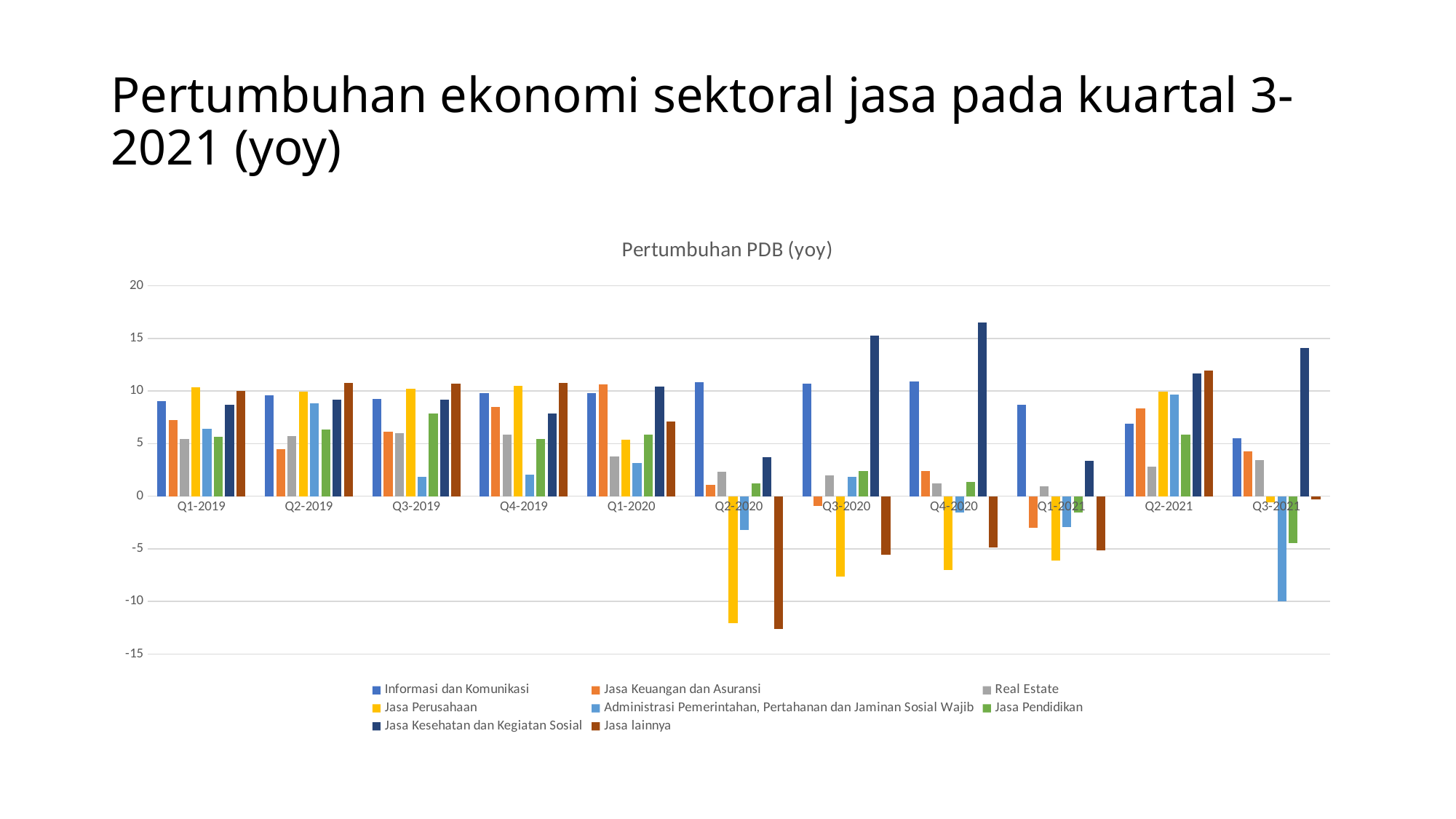
Which series has the highest value in Q4-2020? Jasa Kesehatan dan Kegiatan Sosial Which series has the lowest value in Q3-2021? Administrasi Pemerintahan, Pertahanan dan Jaminan Sosial Wajib Is the value for Jasa Kesehatan dan Kegiatan Sosial in Q1-2021 greater or less than 5? less Is the value for Jasa Perusahaan in Q3-2020 greater or less than -5? less What kind of chart is shown on the slide? Bar chart Is the value for Jasa Kesehatan dan Kegiatan Sosial in Q3-2021 greater or less than 10? greater What is the title of the chart? Pertumbuhan PDB (yoy) How many series does the chart's legend list? 8 How many quarters (categories) are shown on the x axis of the chart? 11 In Q2-2020, which is larger: the value for Informasi dan Komunikasi or the value for Jasa Kesehatan dan Kegiatan Sosial? Informasi dan Komunikasi